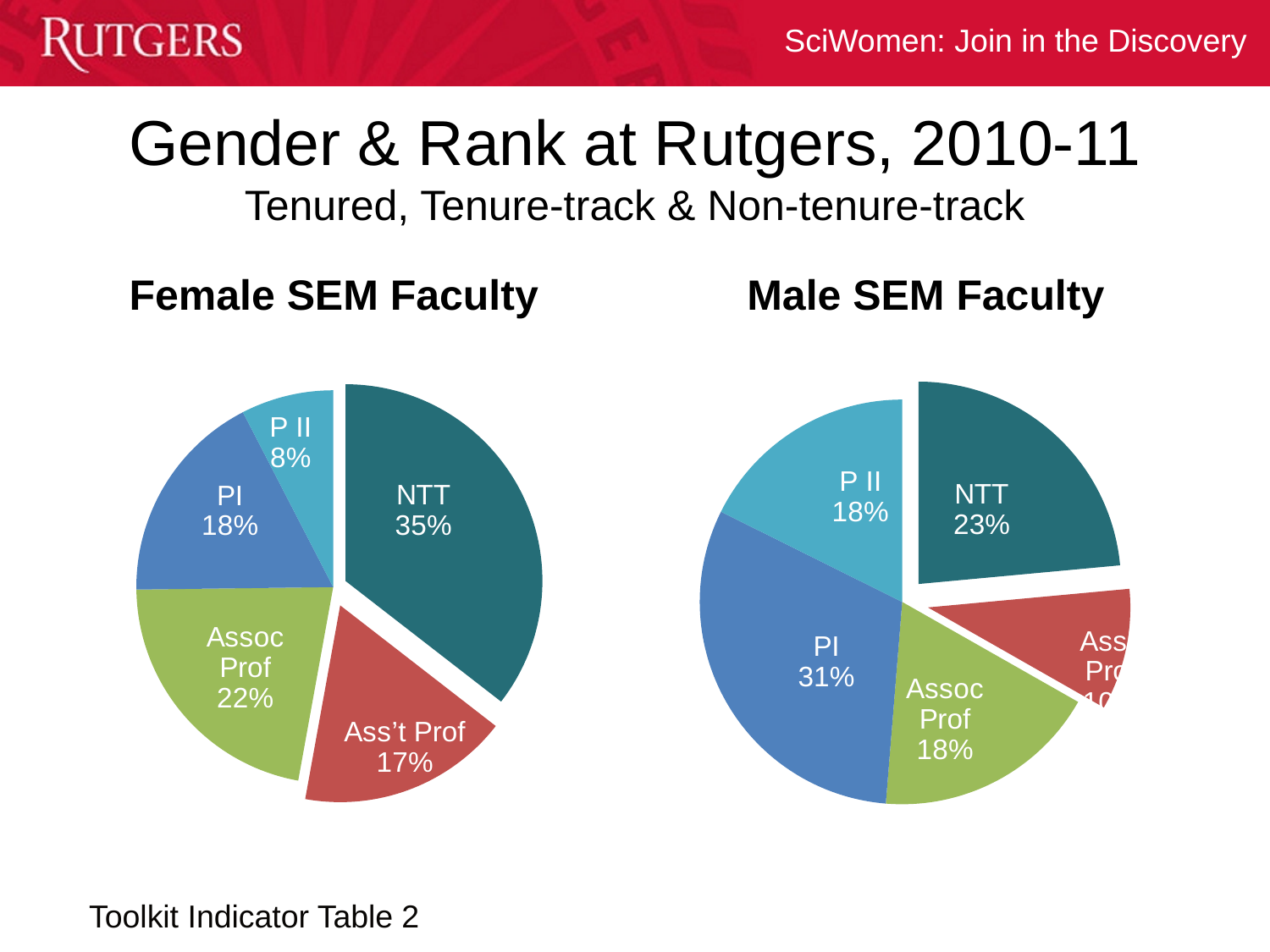
In the Female SEM Faculty chart, what is the difference between the NTT share and the Ass't Prof share? 18% In the Male SEM Faculty chart, which category has the largest share? PI What type of chart is used for the Male SEM Faculty data? Pie chart In the Female SEM Faculty chart, what percentage is P II? 8% In the Female SEM Faculty chart, which category has the largest share? NTT In the Female SEM Faculty chart, what percentage is Assoc Prof? 22% How many slices does the Female SEM Faculty pie chart have? 5 In the Male SEM Faculty chart, what percentage is PI? 31% In the Male SEM Faculty chart, what percentage is NTT? 23% In the Male SEM Faculty chart, which is larger, the PI share or the NTT share? PI In the Female SEM Faculty chart, what share of the pie is NTT? 35% In the Female SEM Faculty chart, which category has the smallest share? P II